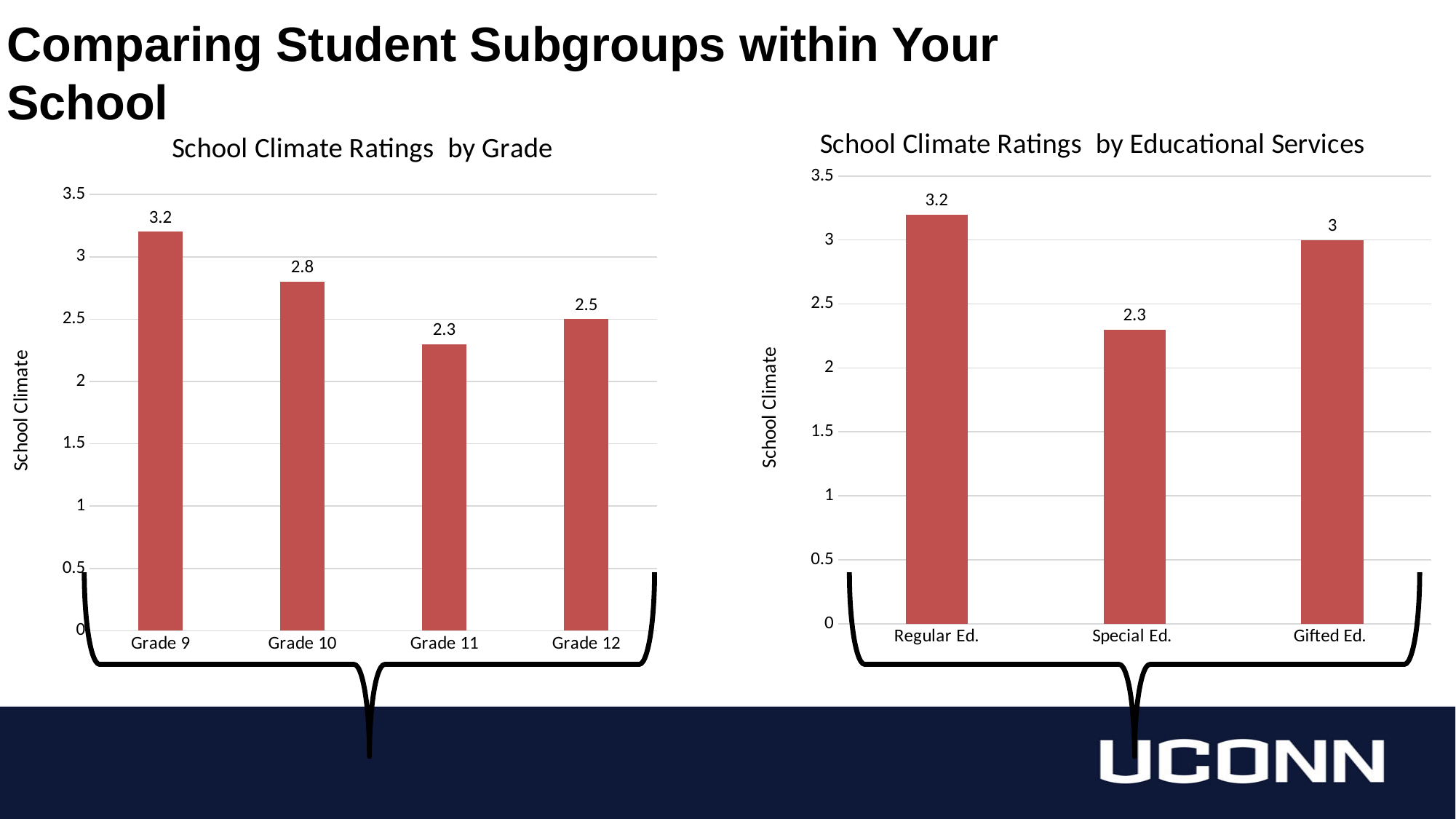
In the 'School Climate Ratings by Educational Services' chart, what is the value for Special Ed.? 2.3 In the 'School Climate Ratings by Grade' chart, is the value for Grade 11 greater or less than 2.5? less In the 'School Climate Ratings by Grade' chart, which grade has the lowest rating? Grade 11 In the 'School Climate Ratings by Educational Services' chart, what is the difference between Regular Ed. and Special Ed.? 0.9 What type of chart is the 'School Climate Ratings by Educational Services' chart? Bar chart In the 'School Climate Ratings by Educational Services' chart, what is the value for Gifted Ed.? 3 In the 'School Climate Ratings by Grade' chart, what is the value for Grade 10? 2.8 In the 'School Climate Ratings by Grade' chart, which grade has the highest rating? Grade 9 In the 'School Climate Ratings by Educational Services' chart, which is larger, Regular Ed. or Gifted Ed.? Regular Ed. In the 'School Climate Ratings by Grade' chart, how many grades are shown? 4 In the 'School Climate Ratings by Grade' chart, what is the difference between the Grade 9 and Grade 12 values? 0.7 In the 'School Climate Ratings by Educational Services' chart, which category has the lowest rating? Special Ed.